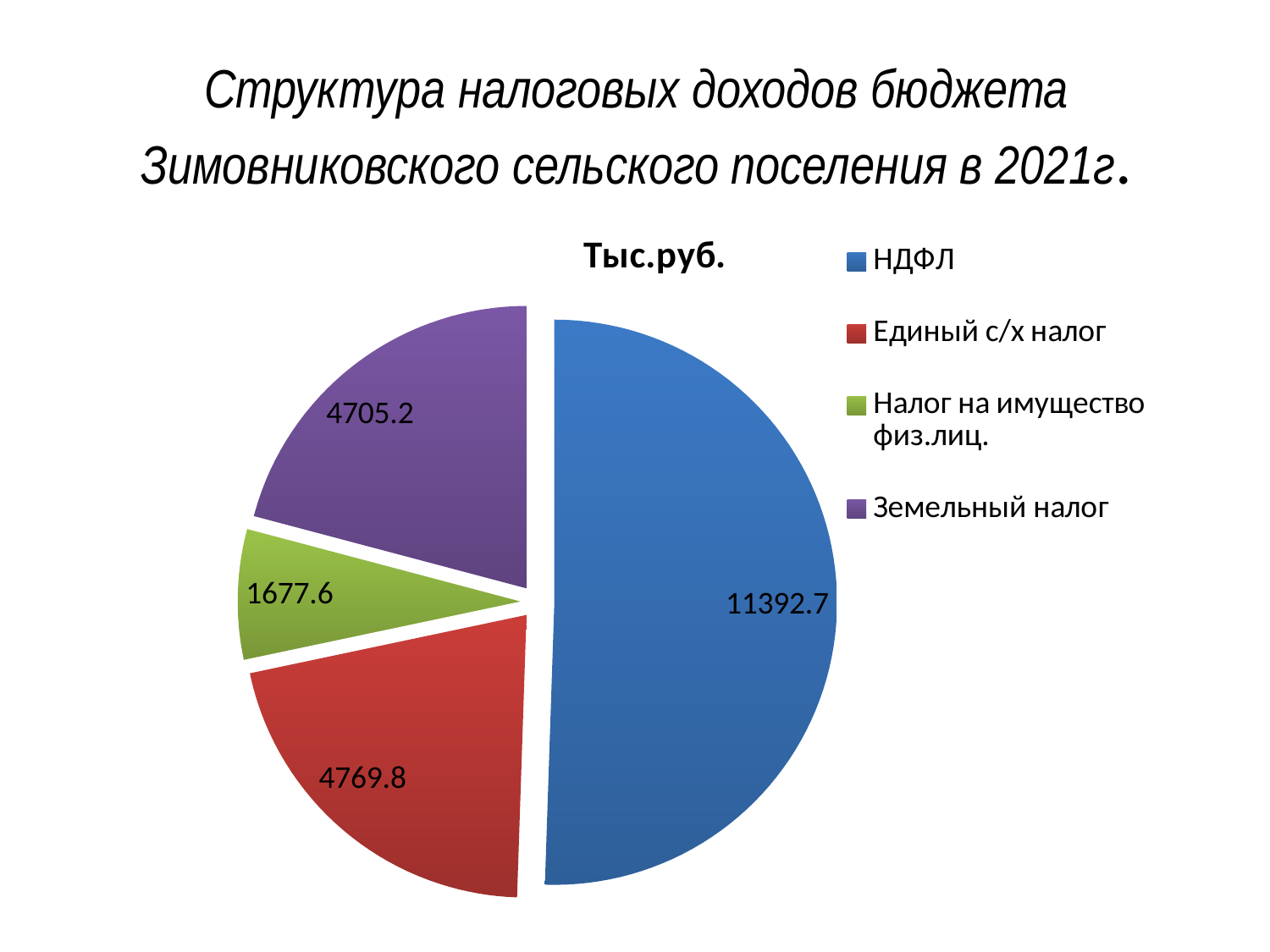
What type of chart is shown on the slide? pie chart What is the difference between the values for НДФЛ and Единый с/х налог? 6622.9 What is the value for Налог на имущество физ.лиц.? 1677.6 What is the difference between the values for Единый с/х налог and Земельный налог? 64.6 What is the title shown above the pie chart? Тыс.руб. Which is larger, the value for Единый с/х налог or the value for Земельный налог? Единый с/х налог How many categories does the pie chart show? 4 Which category has the smallest slice of the pie? Налог на имущество физ.лиц. Which category has the largest slice of the pie? НДФЛ What is the value for Земельный налог? 4705.2 What is the value for НДФЛ? 11392.7 What is the value for Единый с/х налог? 4769.8